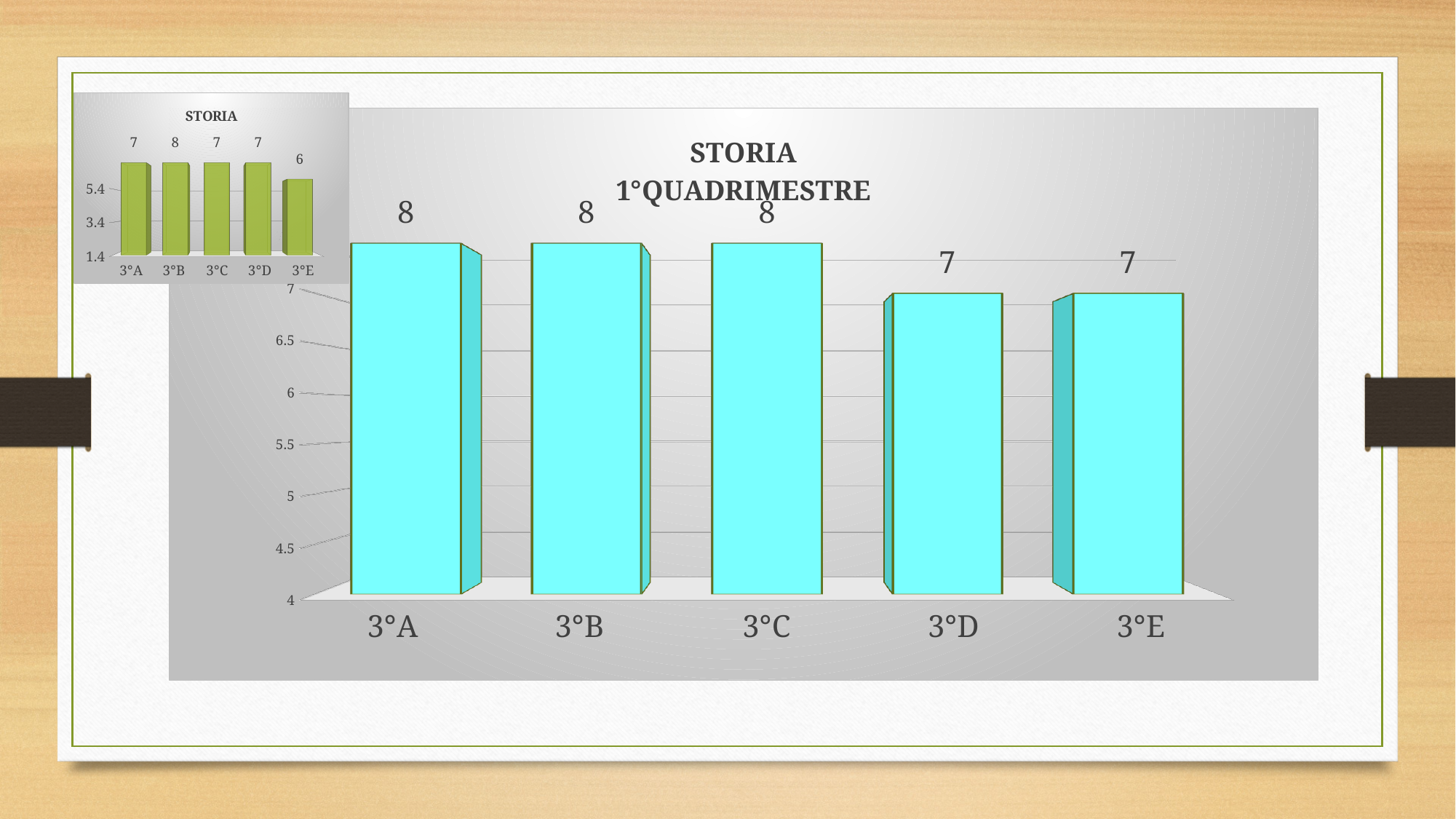
In the large 'STORIA 1°QUADRIMESTRE' chart, what is the value for 3°A? 8 In the small 'STORIA' chart at the top left, what is the value for 3°E? 6 In the large 'STORIA 1°QUADRIMESTRE' chart, do the values rise or fall from 3°A to 3°E? Fall In the small 'STORIA' chart at the top left, which category has the highest value? 3°B In the large 'STORIA 1°QUADRIMESTRE' chart, what is the value for 3°D? 7 In the small 'STORIA' chart at the top left, what is the value for 3°B? 8 In the large 'STORIA 1°QUADRIMESTRE' chart, which is larger, the value for 3°B or the value for 3°D? 3°B How many categories are shown in the large 'STORIA 1°QUADRIMESTRE' chart? 5 What kind of chart is the large 'STORIA 1°QUADRIMESTRE' chart? Bar chart In the small 'STORIA' chart at the top left, which category has the lowest value? 3°E In the large 'STORIA 1°QUADRIMESTRE' chart, what is the difference between the values for 3°C and 3°E? 1 In the small 'STORIA' chart at the top left, what is the difference between the values for 3°B and 3°E? 2